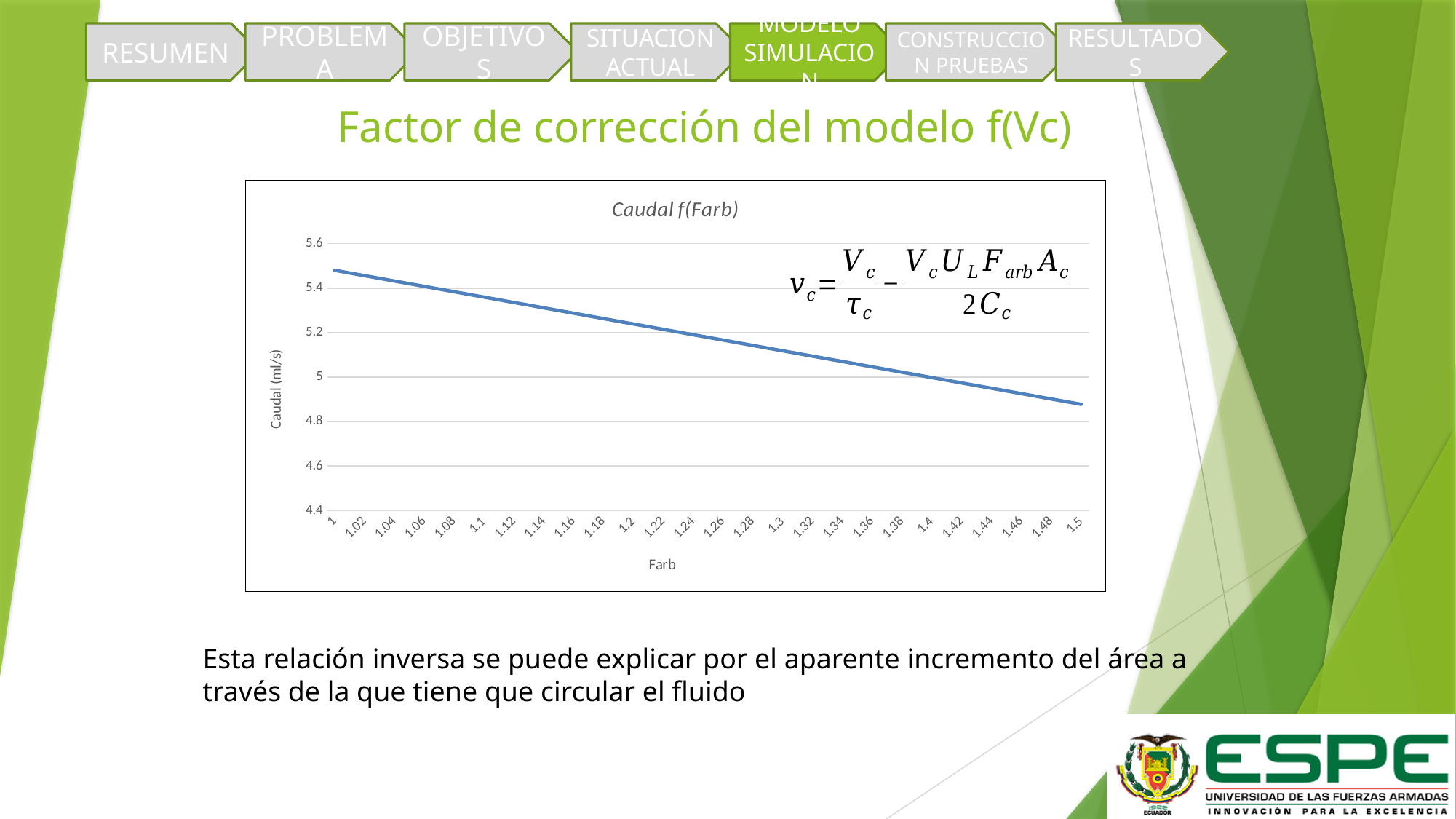
Is the Caudal value at Farb = 1.5 greater or less than 5? less What is the label of the y axis of the chart? Caudal (ml/s) What kind of chart is shown on the slide? line chart Which has the larger Caudal value, Farb = 1.1 or Farb = 1.4? Farb = 1.1 At which Farb value is the Caudal highest? 1 At which Farb value is the Caudal lowest? 1.5 Do the values of Caudal rise or fall as Farb increases along the x axis? fall Is the Caudal value at Farb = 1 greater or less than 5.4? greater Is the Caudal value at Farb = 1.4 greater or less than 4.8? greater What is the title of the chart? Caudal f(Farb) How many Farb tick labels are shown along the x axis? 26